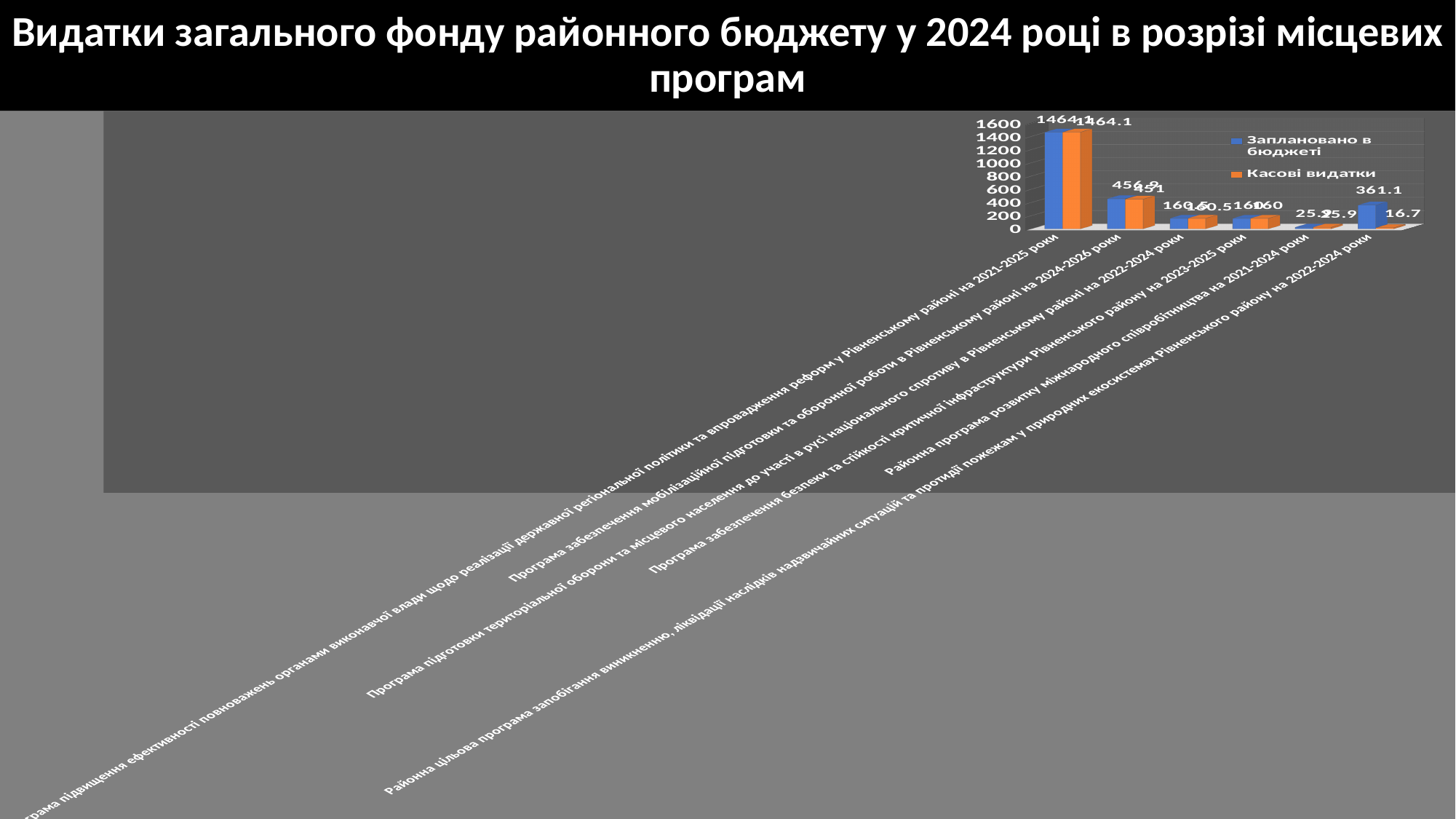
What is the value of 'Касові видатки' for 'Районна цільова програма запобігання виникненню, ліквідації наслідків надзвичайних ситуацій та протидії пожежам у природних екосистемах Рівненського району на 2022-2024 роки'? 16.7 Is the 'Заплановано в бюджеті' value for 'Програма забезпечення мобілізаційної підготовки та оборонної роботи в Рівненському районі на 2024-2026 роки' greater or less than 400? greater What is the value of 'Заплановано в бюджеті' for 'Районна цільова програма запобігання виникненню, ліквідації наслідків надзвичайних ситуацій та протидії пожежам у природних екосистемах Рівненського району на 2022-2024 роки'? 361.1 What are the two series named in the chart legend? Заплановано в бюджеті; Касові видатки What is the value of 'Заплановано в бюджеті' for 'Програма забезпечення мобілізаційної підготовки та оборонної роботи в Рівненському районі на 2024-2026 роки'? 456.9 For 'Районна цільова програма запобігання виникненню, ліквідації наслідків надзвичайних ситуацій та протидії пожежам у природних екосистемах Рівненського району на 2022-2024 роки', which is larger: 'Заплановано в бюджеті' or 'Касові видатки'? Заплановано в бюджеті What is the difference between 'Заплановано в бюджеті' and 'Касові видатки' for 'Районна цільова програма запобігання виникненню, ліквідації наслідків надзвичайних ситуацій та протидії пожежам у природних екосистемах Рівненського району на 2022-2024 роки'? 344.4 What kind of chart is shown on the slide? bar chart How many programs (categories) are plotted on the chart? 6 How many series does the chart legend list? 2 Which program has the highest 'Заплановано в бюджеті' value? Програма підвищення ефективності повноважень органами виконавчої влади щодо реалізації державної регіональної політики та впровадження реформ у Рівненському районі на 2021-2025 роки What is the value of 'Касові видатки' for 'Програма забезпечення мобілізаційної підготовки та оборонної роботи в Рівненському районі на 2024-2026 роки'? 451